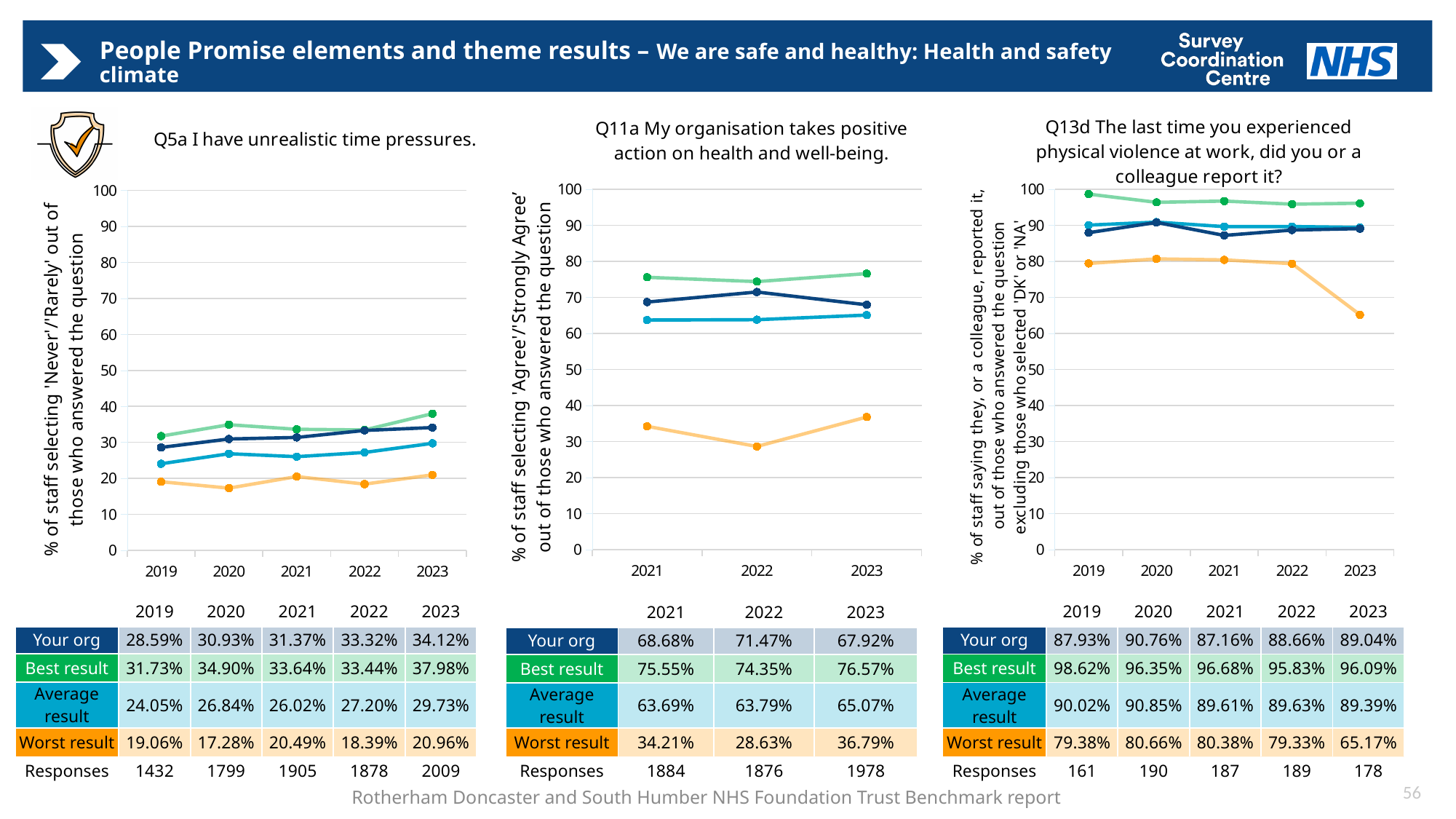
In the Q13d chart about reporting physical violence at work, which year has the highest 'Best result' value? 2019 What kind of chart is used for Q5a 'I have unrealistic time pressures'? line chart In the Q13d chart about reporting physical violence at work, what is the 'Worst result' value for 2023? 65.17% In the Q5a 'I have unrealistic time pressures' chart, what is the 'Worst result' value for 2020? 17.28% In the Q11a 'My organisation takes positive action on health and well-being' chart, is the 'Your org' value for 2022 larger or smaller than the 'Average result' value for 2022? larger In the Q5a 'I have unrealistic time pressures' chart, what is the difference between the 'Best result' and 'Your org' values for 2023? 3.86% In the Q5a 'I have unrealistic time pressures' chart, does the 'Your org' line rise or fall from 2019 to 2023? rise In the Q5a 'I have unrealistic time pressures' chart, what is the 'Your org' value for 2023? 34.12% In the Q11a 'My organisation takes positive action on health and well-being' chart, which year has the lowest 'Worst result' value? 2022 In the Q11a 'My organisation takes positive action on health and well-being' chart, what is the 'Best result' value for 2023? 76.57% In the Q13d chart about reporting physical violence at work, is the 'Worst result' value for 2023 greater or less than 70? less How many years are plotted on the x axis of the Q11a 'My organisation takes positive action on health and well-being' chart? 3